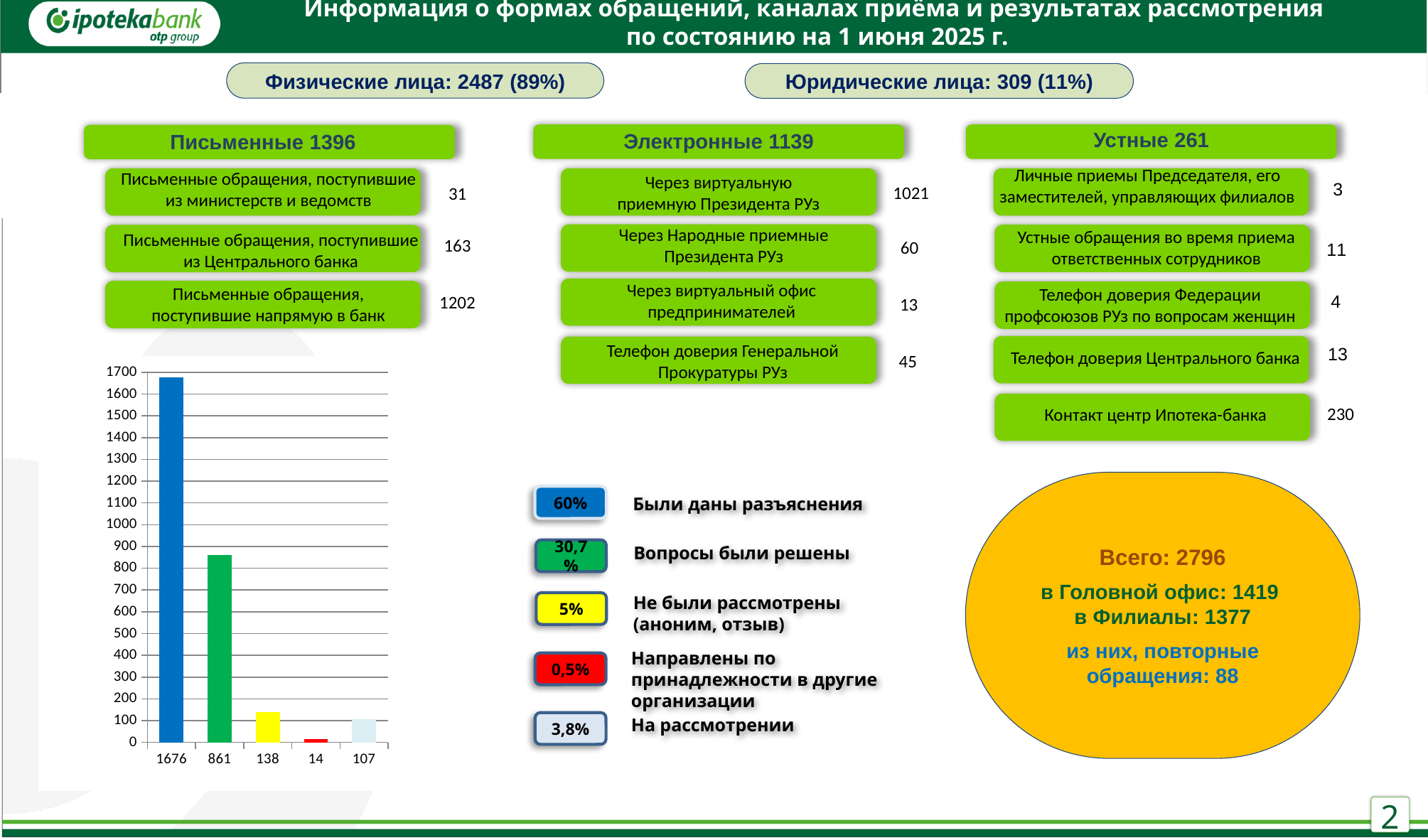
What kind of chart is shown on the slide? bar chart What value does the green (second) bar in the bar chart represent? 861 How many bars does the bar chart contain? 5 What is the highest value shown on the vertical axis of the bar chart? 1700 What is the value of the tallest bar in the bar chart? 1676 What is the value of the shortest bar in the bar chart? 14 What value does the blue (first) bar in the bar chart represent? 1676 What value does the yellow (third) bar in the bar chart represent? 138 What is the difference between the yellow bar (138) and the red bar (14) in the bar chart? 124 What is the difference between the first bar (1676) and the second bar (861) in the bar chart? 815 Which is larger in the bar chart: the yellow bar (138) or the light blue bar (107)? 138 Is the value of the green bar in the bar chart greater or less than 900? less